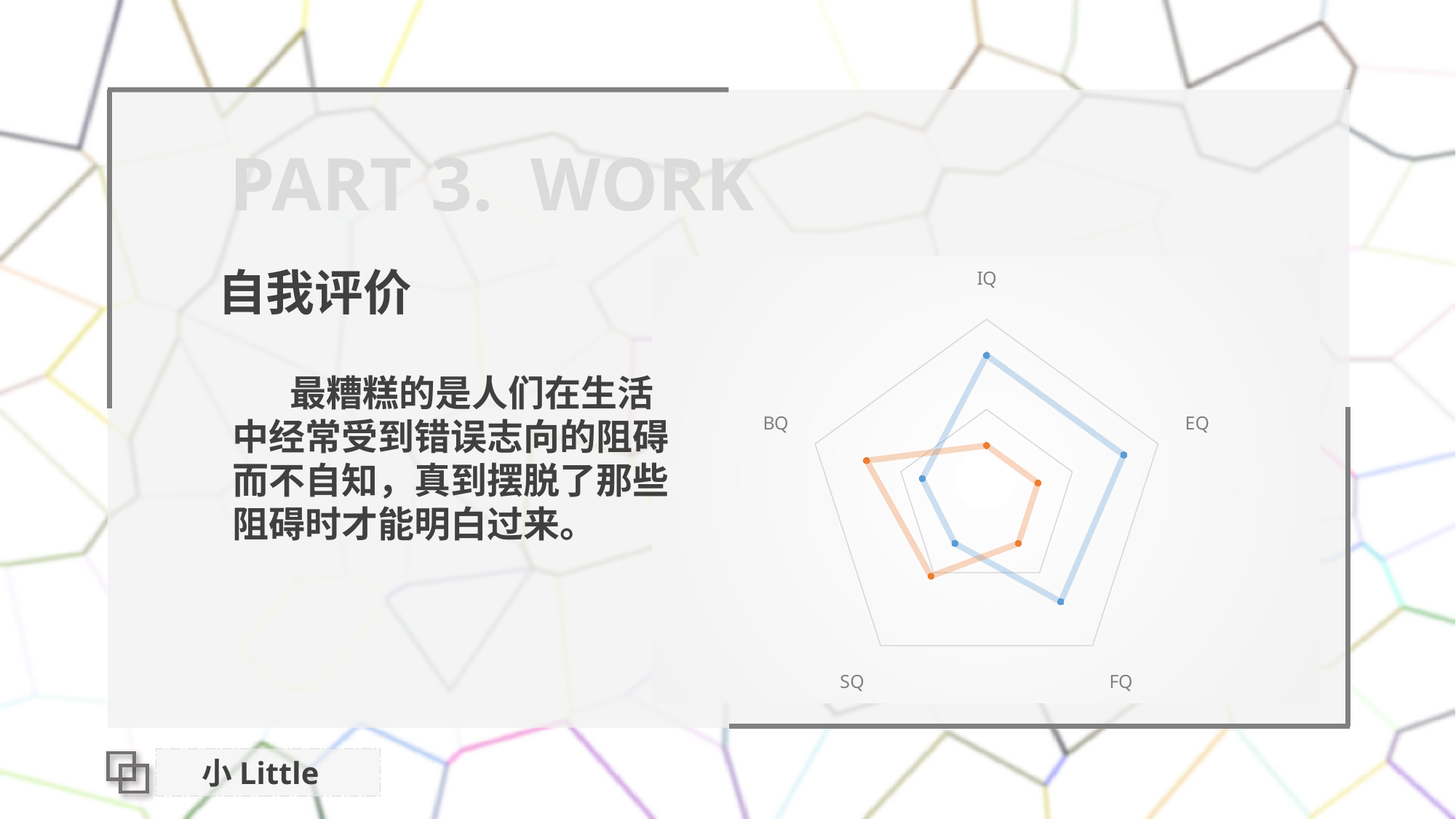
Which category label is placed at the top of the radar chart? IQ On which category does the orange series have its highest value? BQ What are the category labels on the radar chart? IQ, EQ, FQ, SQ, BQ What kind of chart is shown on the slide? radar chart For SQ, which series has the larger value, the blue one or the orange one? orange How many categories (axes) does the radar chart have? 5 For BQ, which series has the larger value, the blue one or the orange one? orange For EQ, which series has the larger value, the blue one or the orange one? blue How many data series are plotted on the radar chart? 2 On which category does the blue series have its lowest value? SQ